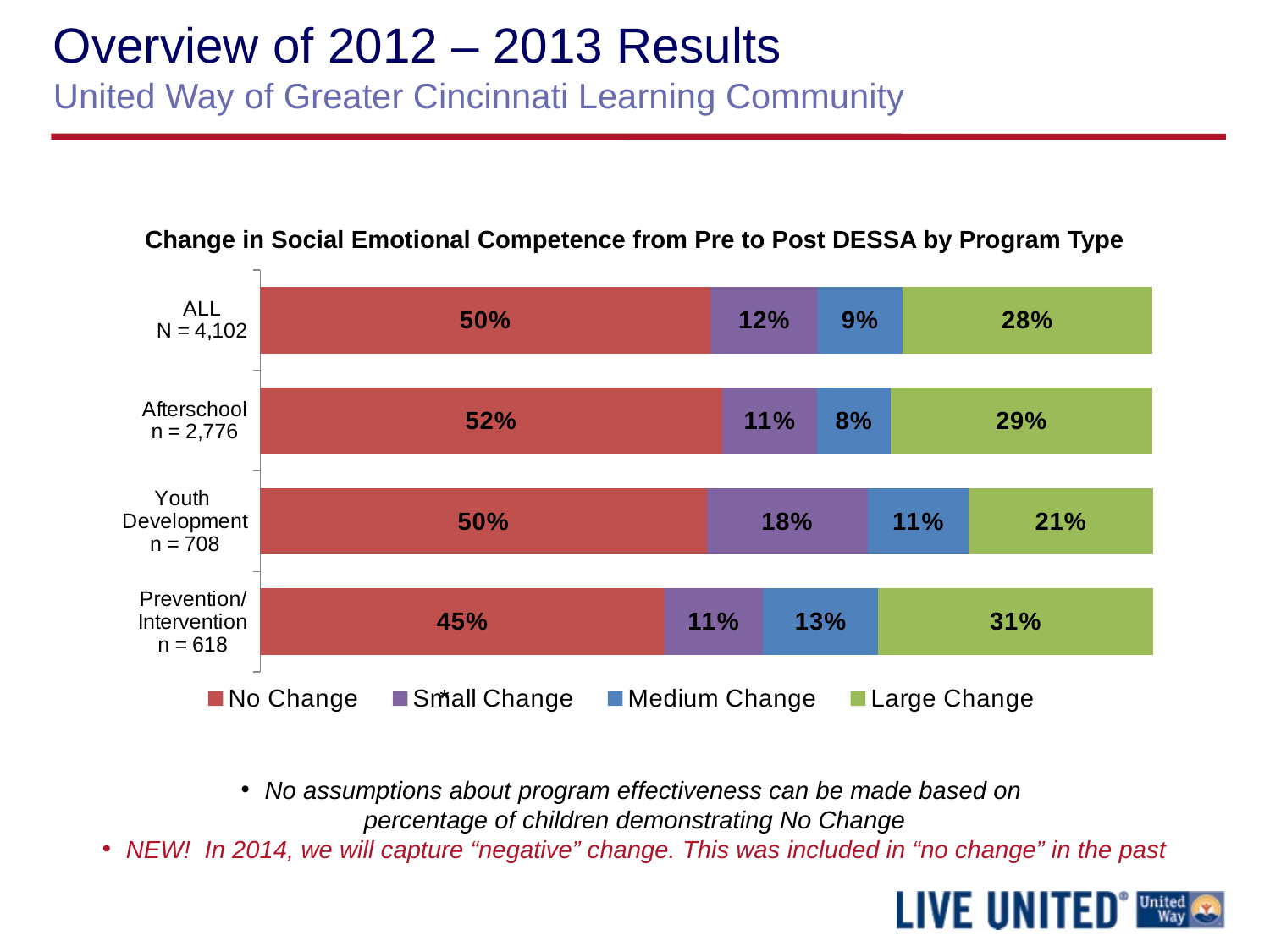
What is the sample size (n) shown for Youth Development? 708 Which program type has the highest Large Change percentage? Prevention/Intervention How many series does the legend list? 4 Which is larger, the Medium Change value for Youth Development or for Afterschool? Youth Development What is the No Change value for Afterschool? 52% What is the Medium Change value for ALL? 9% How many program type categories are shown in the chart? 4 Which program type has the lowest No Change percentage? Prevention/Intervention What is the difference between the Large Change values for Afterschool and Youth Development? 8% What is the Small Change value for Youth Development? 18% What kind of chart is shown on the slide? Stacked bar chart What is the Large Change value for Prevention/Intervention? 31%